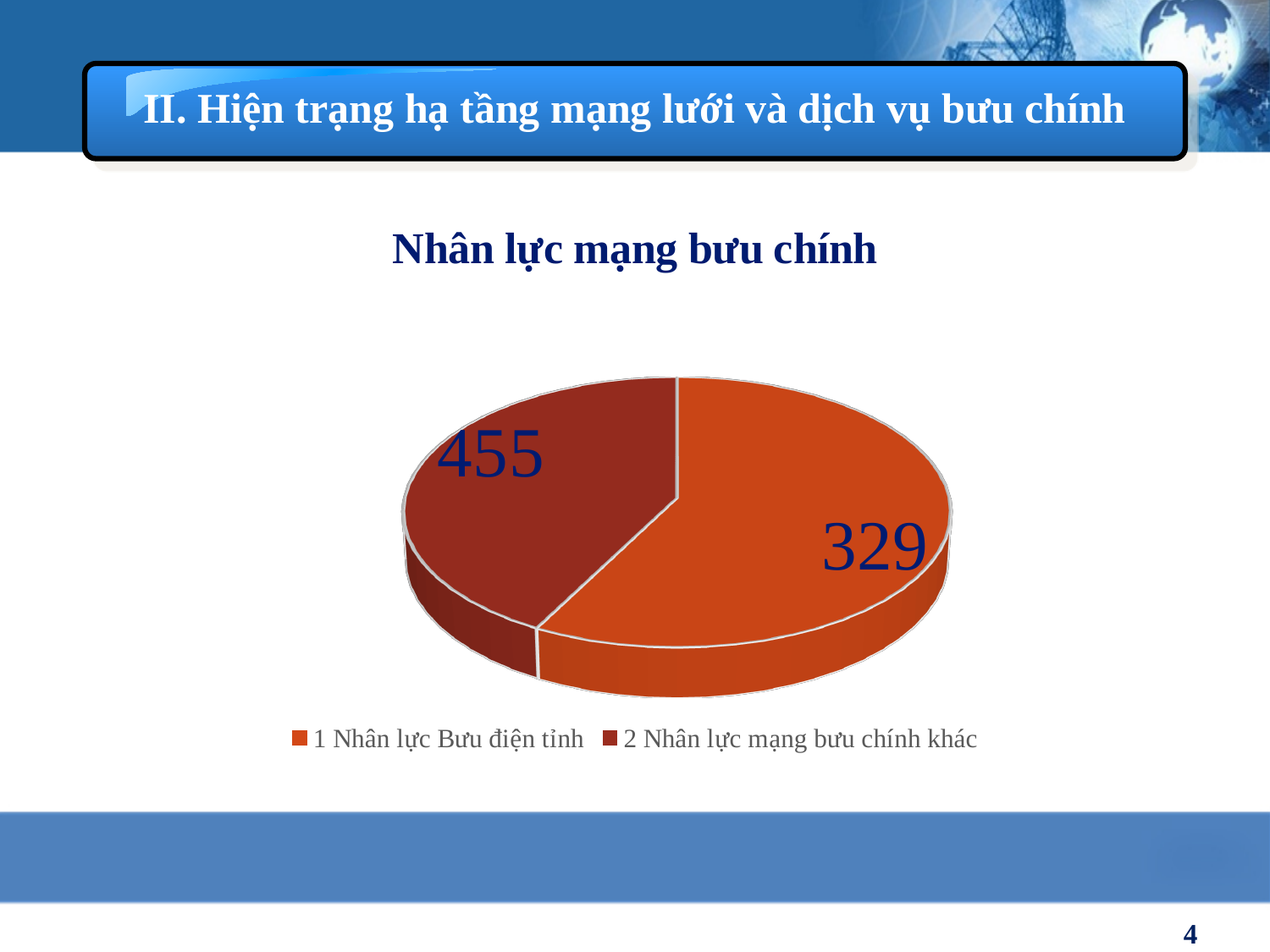
What is the total of the two values printed on the pie chart? 784 How many entries does the chart legend list? 2 What is the title of the chart? Nhân lực mạng bưu chính What are the two values printed on the pie chart? 455 and 329 What is the difference between the two values printed on the pie chart? 126 What kind of chart is shown on the slide? Pie chart How many slices does the pie chart have? 2 What is the larger of the two values printed on the pie chart? 455 What is the smaller of the two values printed on the pie chart? 329 What is the first legend entry of the chart? 1 Nhân lực Bưu điện tỉnh